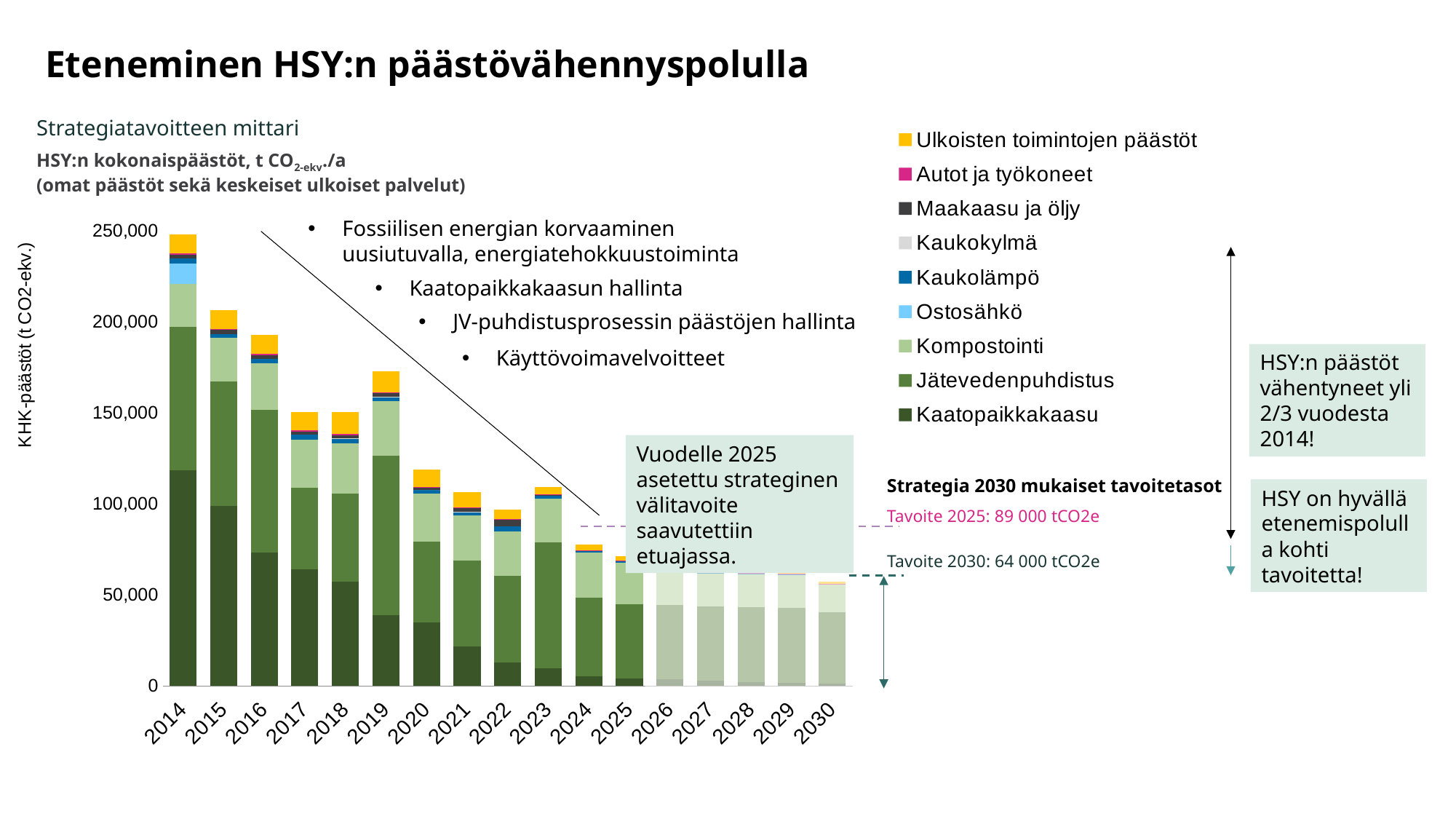
Is the total emissions value for 2024 greater or less than 100,000? less How many series does the chart legend list? 9 Do the total emissions generally rise or fall from 2014 to 2030? Fall Which year has the highest total emissions in the chart? 2014 Is the total emissions value for 2014 greater or less than 200,000? greater What is the label of the y axis of the chart? KHK-päästöt (t CO2-ekv.) Which year has larger total emissions, 2016 or 2017? 2016 Is the total emissions value for 2025 greater or less than 100,000? less What kind of chart is shown on the slide? Stacked bar chart Which year has larger total emissions, 2019 or 2020? 2019 How many years are shown on the x axis of the chart? 17